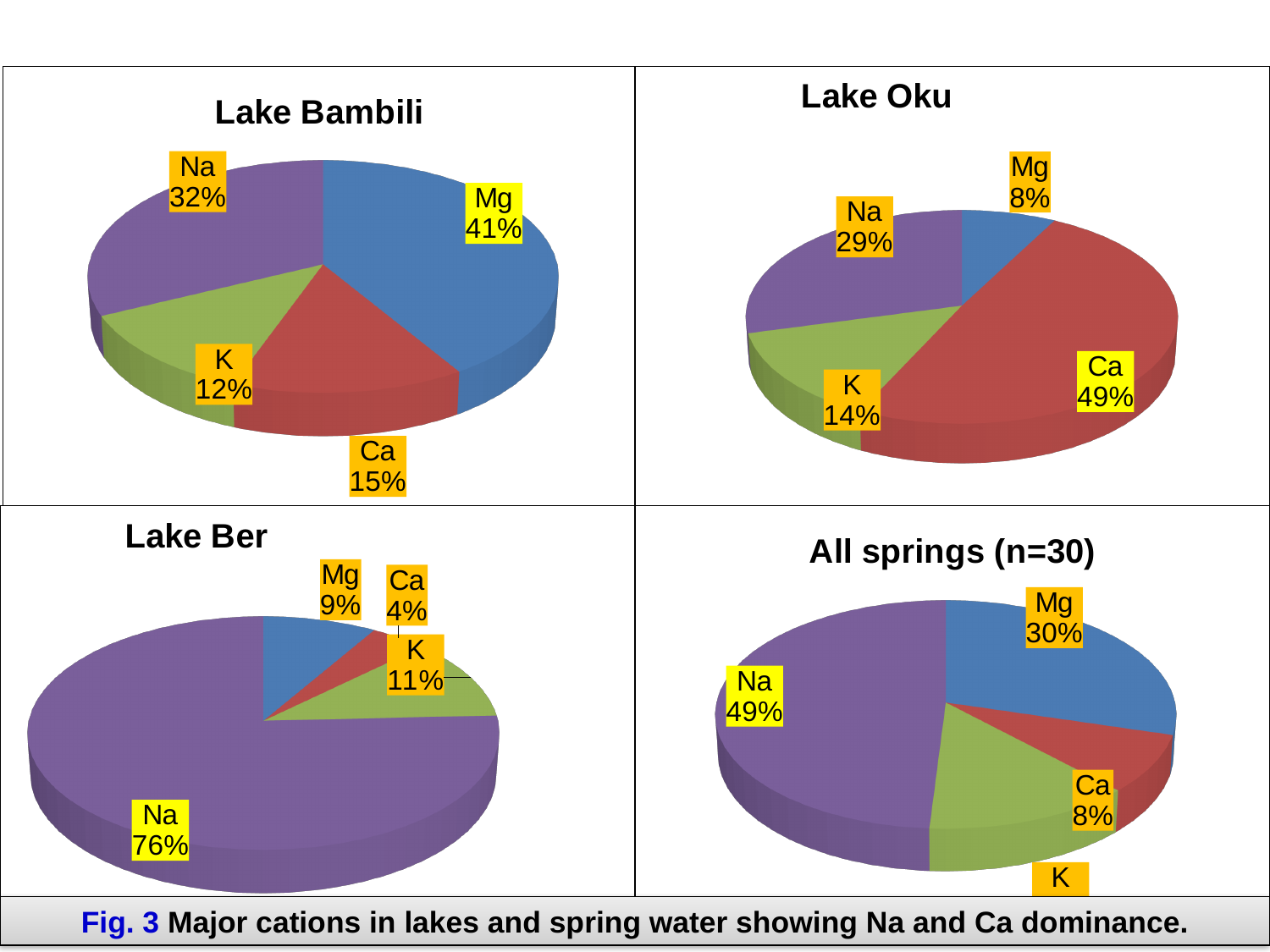
In the Lake Ber chart, what share does Na have? 76% In the Lake Bambili chart, what share does Mg have? 41% In the All springs (n=30) chart, which cation has the largest slice? Na What kind of chart is used for Lake Oku? Pie chart In the Lake Oku chart, what is the value for Ca? 49% In the Lake Oku chart, which cation has the largest slice? Ca In the Lake Bambili chart, which cation has the smallest slice? K In the All springs (n=30) chart, what share does Mg have? 30% In the Lake Oku chart, what is the difference between the Na and Mg shares? 21% In the Lake Ber chart, which is larger, Mg or Ca? Mg How many slices does the Lake Bambili chart have? 4 In the Lake Ber chart, what is the value for K? 11%